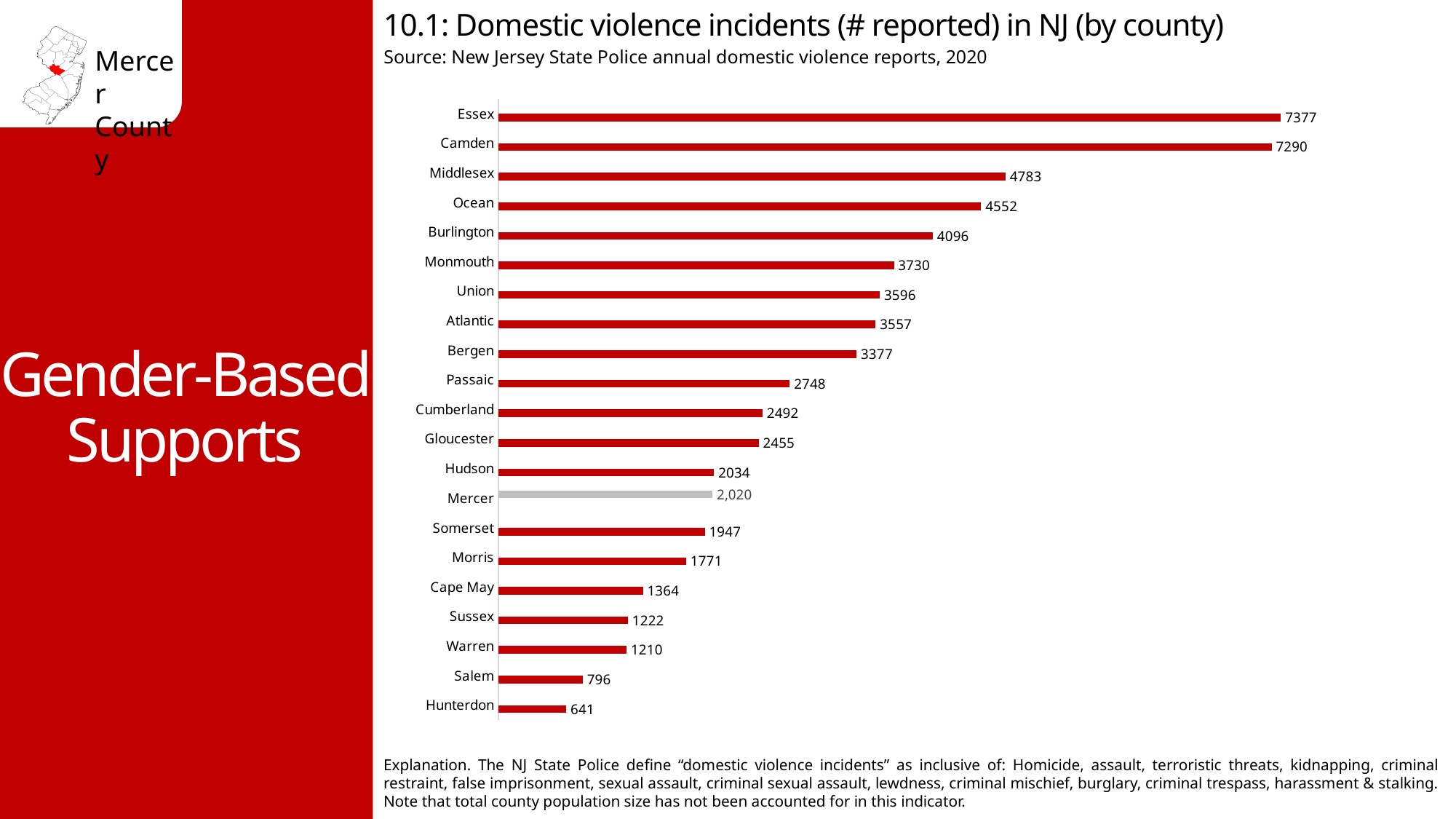
What is the number of reported domestic violence incidents for Hudson County? 2034 What is the number of reported domestic violence incidents for Essex County? 7377 How many counties are shown in the chart? 21 What is the difference in reported incidents between Essex and Camden? 87 Which county's bar is shown in grey rather than red? Mercer Which county has the lowest number of reported domestic violence incidents? Hunterdon Which county has the highest number of reported domestic violence incidents? Essex Which county has more reported incidents, Salem or Hunterdon? Salem Which county has more reported incidents, Burlington or Monmouth? Burlington What type of chart is used to show domestic violence incidents by county? Bar chart What is the difference in reported incidents between Middlesex and Ocean? 231 What is the number of reported domestic violence incidents for Mercer County? 2,020